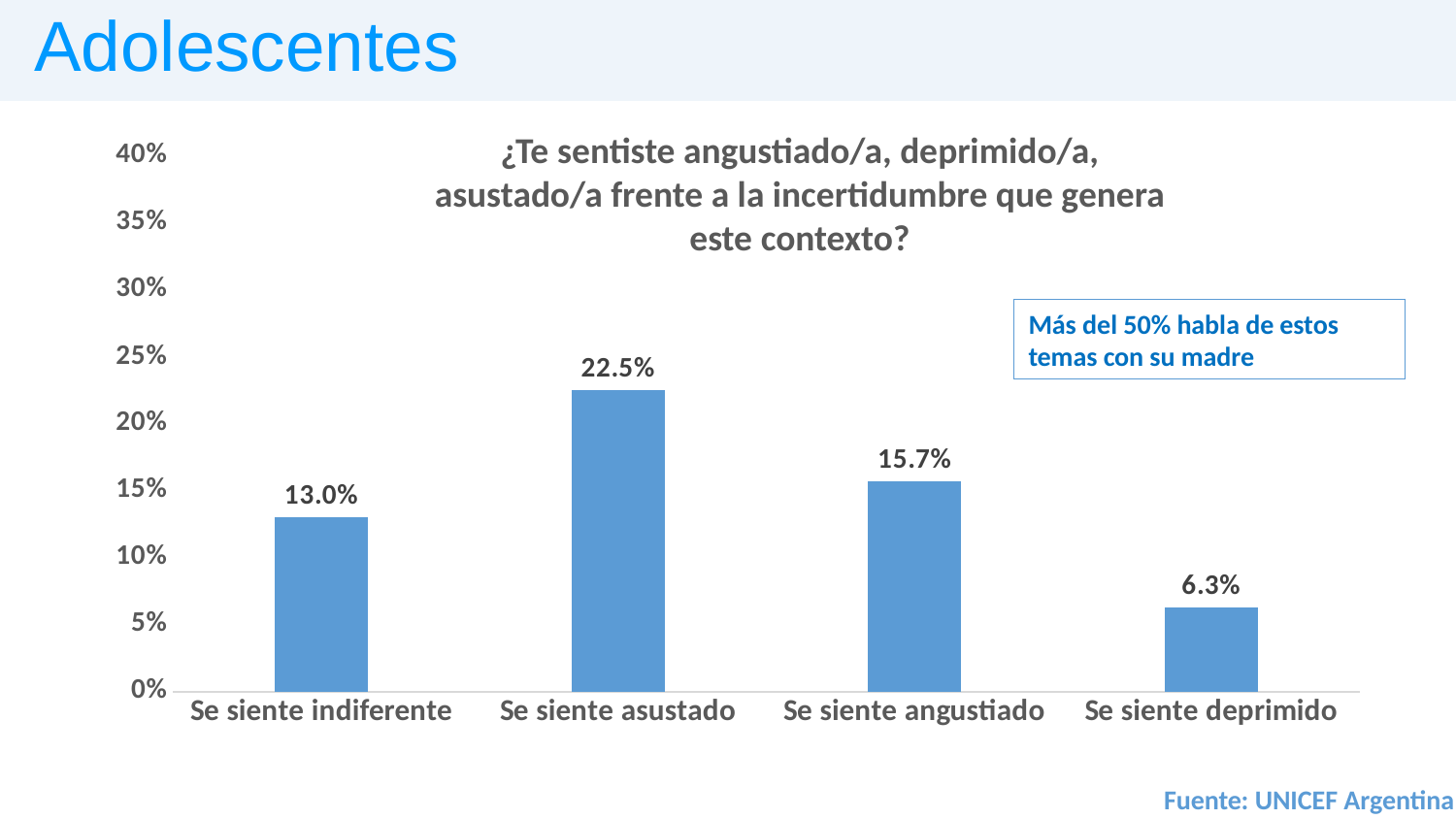
What is the difference between the values for "Se siente asustado" and "Se siente angustiado"? 6.8% What kind of chart is shown on the slide? Bar chart What is the title of the chart? ¿Te sentiste angustiado/a, deprimido/a, asustado/a frente a la incertidumbre que genera este contexto? What is the value for "Se siente indiferente"? 13.0% What is the value for "Se siente asustado"? 22.5% How many categories are shown on the x axis? 4 Is the value for "Se siente asustado" greater or less than 20%? greater Which category has the lowest value? Se siente deprimido What is the value for "Se siente deprimido"? 6.3% Which is larger, the value for "Se siente indiferente" or the value for "Se siente angustiado"? Se siente angustiado What source is cited for the chart? UNICEF Argentina Which category has the highest value? Se siente asustado